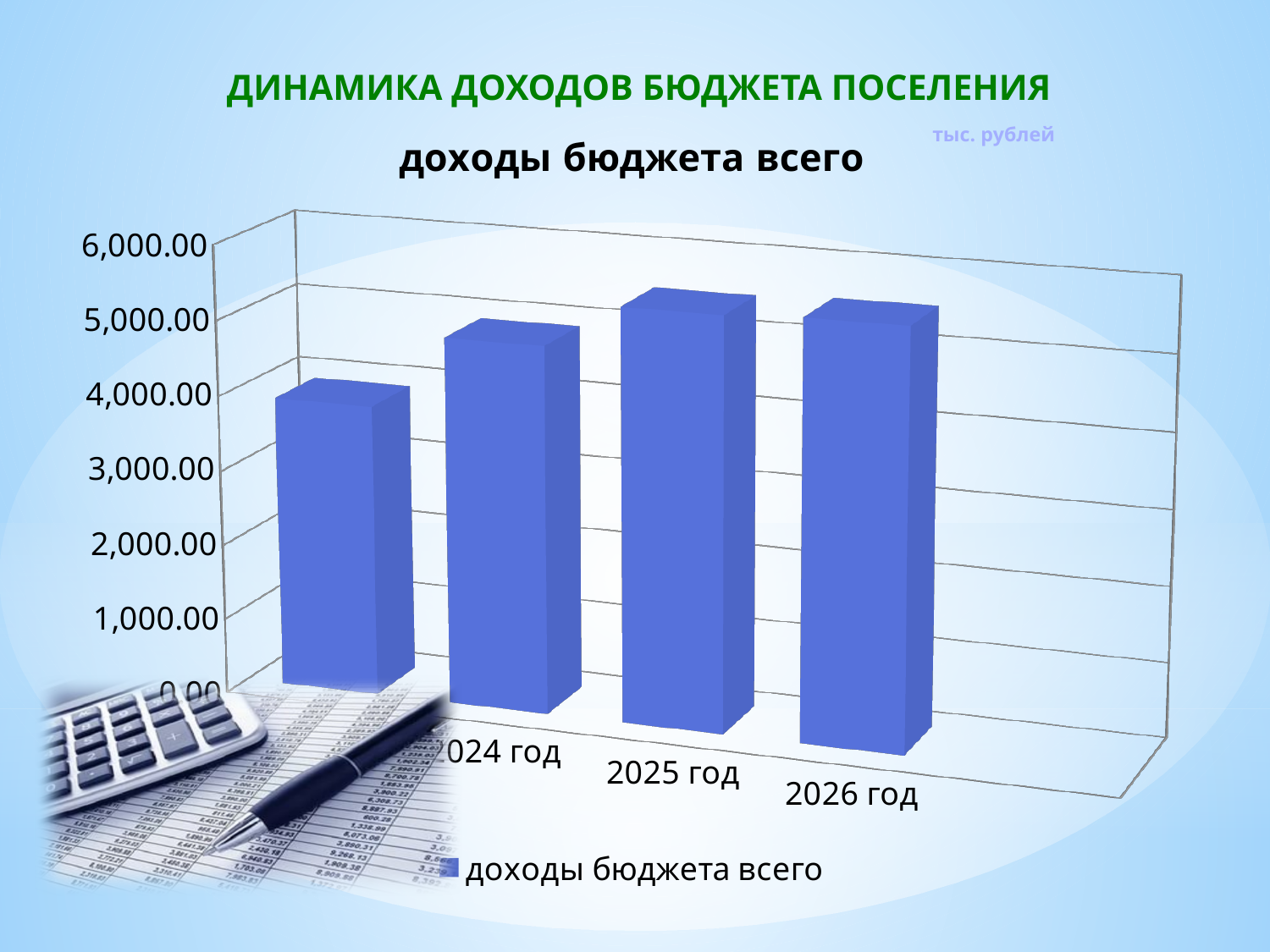
Is the value for 2025 год greater or less than 4,000.00? greater How many series does the legend list? 1 Do the values rise or fall from 2024 год to 2025 год? rise Which is larger, the value for 2024 год or the value for 2026 год? 2026 год How many bars are plotted in the chart? 4 Is the value for 2026 год greater or less than 4,000.00? greater Is the value for 2024 год greater or less than 4,000.00? greater What unit is indicated for the chart values? тыс. рублей What is the title of the chart? доходы бюджета всего What kind of chart is shown on the slide? bar chart Which is larger, the value for 2024 год or the value for 2025 год? 2025 год